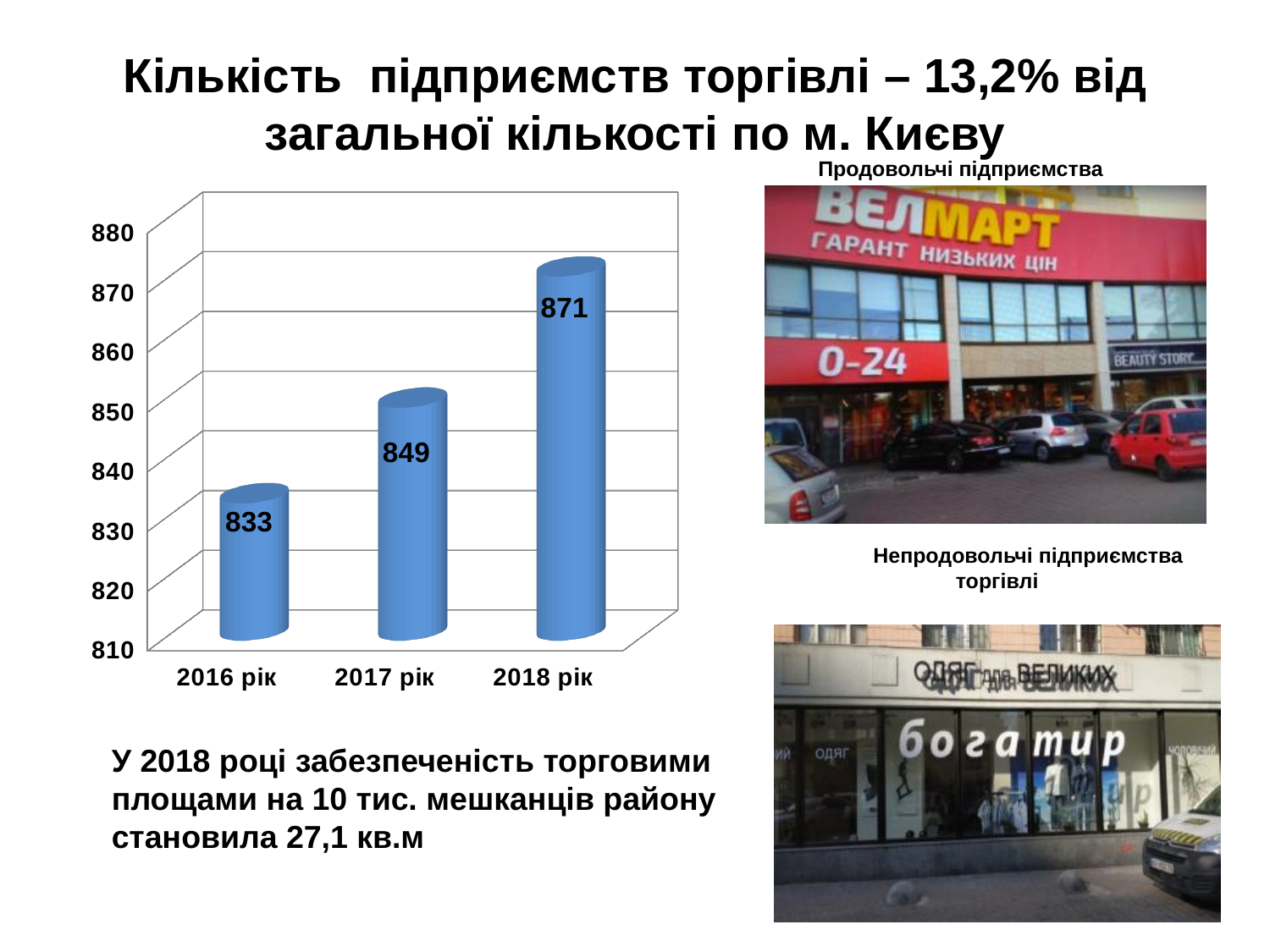
Which year has the lowest value? 2016 рік Which year has the highest value? 2018 рік What is the difference between the values for 2018 рік and 2016 рік? 38 Is the value for 2017 рік greater or less than 840? greater Which is larger, the value for 2017 рік or the value for 2018 рік? 2018 рік What is the value for 2017 рік? 849 How many years are shown on the chart? 3 What is the value for 2018 рік? 871 Do the values rise or fall from 2016 рік to 2018 рік? rise What is the difference between the values for 2017 рік and 2016 рік? 16 What kind of chart is shown on the slide? bar chart What is the value for 2016 рік? 833